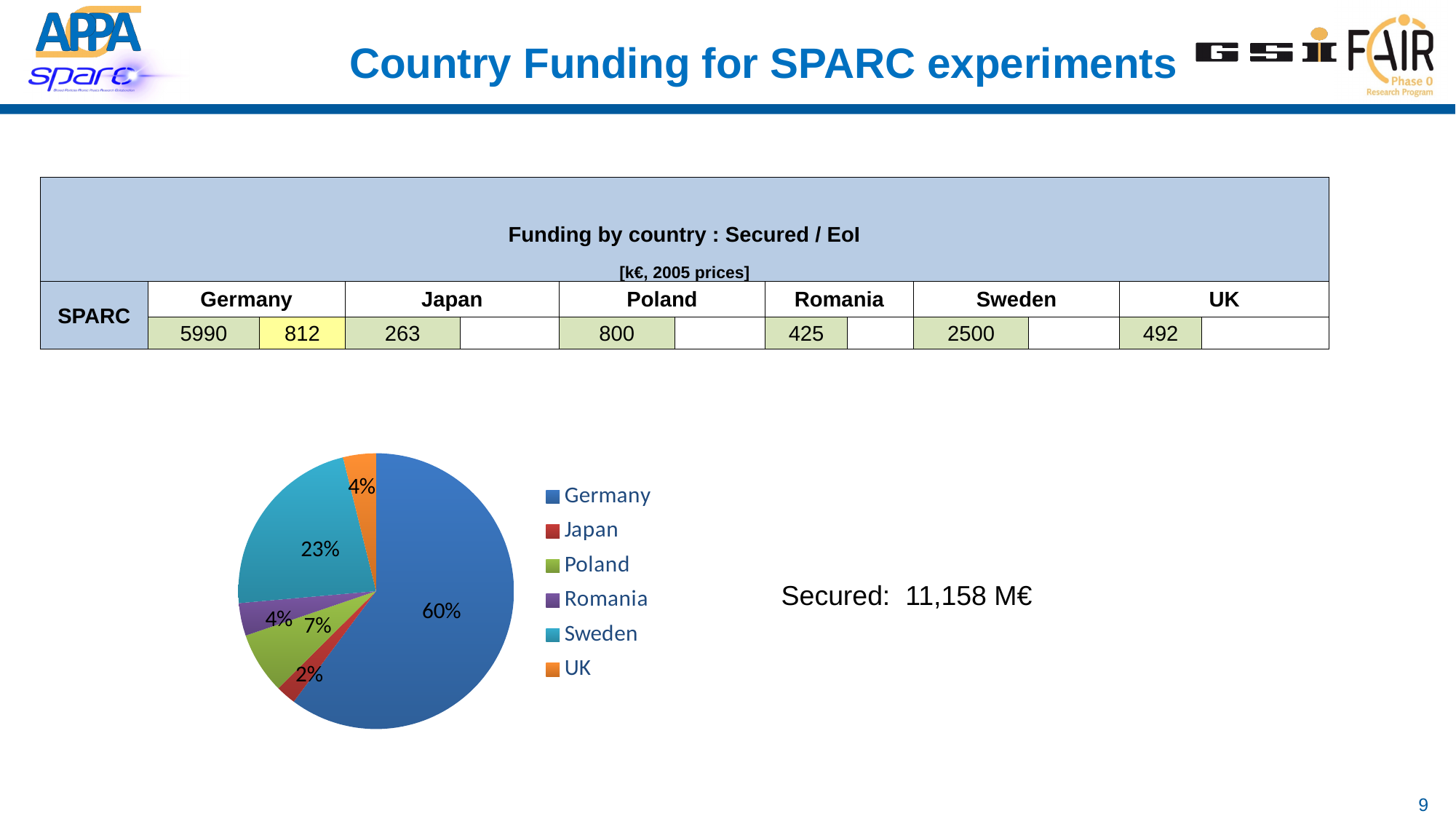
How many countries are shown in the pie chart legend? 6 What is the difference in percentage points between Germany's share and Sweden's share? 37 What share of the pie does Poland have? 7% What share of the pie does Sweden have? 23% Which has a larger share of the pie, Sweden or Poland? Sweden Which country has the smallest slice of the pie? Japan Which country is represented by the orange slice in the pie chart? UK What share of the pie does Japan have? 2% Which country is represented by the purple slice in the pie chart? Romania What kind of chart is shown on the slide? pie chart Which country has the largest slice of the pie? Germany